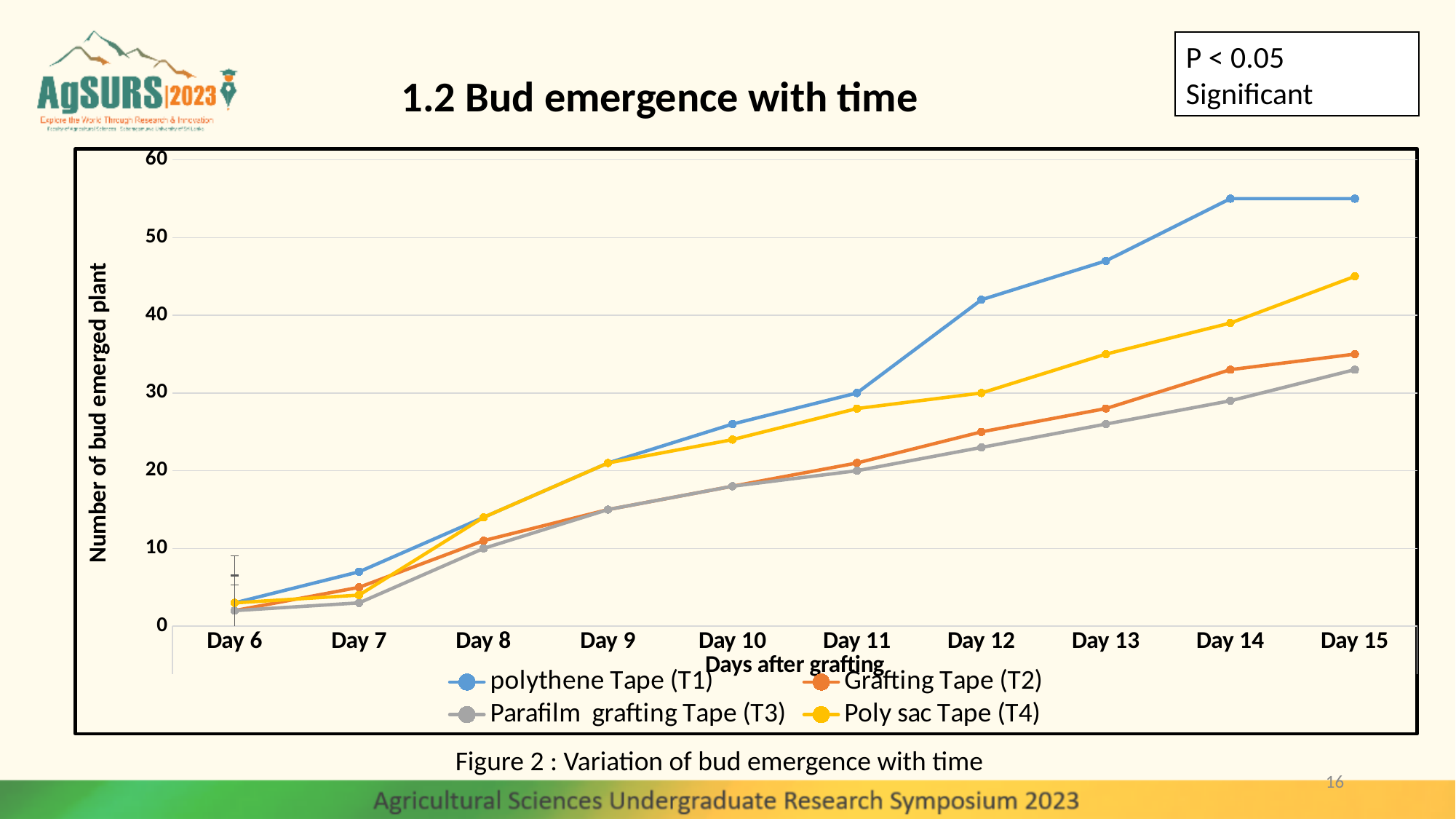
Is the value for Poly sac Tape (T4) at Day 15 greater or less than 40? greater Is the value for polythene Tape (T1) at Day 14 greater or less than 50? greater Is the value for Parafilm grafting Tape (T3) at Day 8 greater or less than 20? less Which series has the lowest number of bud emerged plants at Day 15? Parafilm grafting Tape (T3) Which series has the highest number of bud emerged plants at Day 15? polythene Tape (T1) What is the title of the y axis? Number of bud emerged plant At Day 12, which is larger: polythene Tape (T1) or Grafting Tape (T2)? polythene Tape (T1) How many series does the legend list? 4 What is the title of the x axis? Days after grafting Do the values for polythene Tape (T1) rise or fall from Day 6 to Day 14? rise How many days (x-axis categories) are plotted on the chart? 10 What kind of chart is shown on the slide? line chart